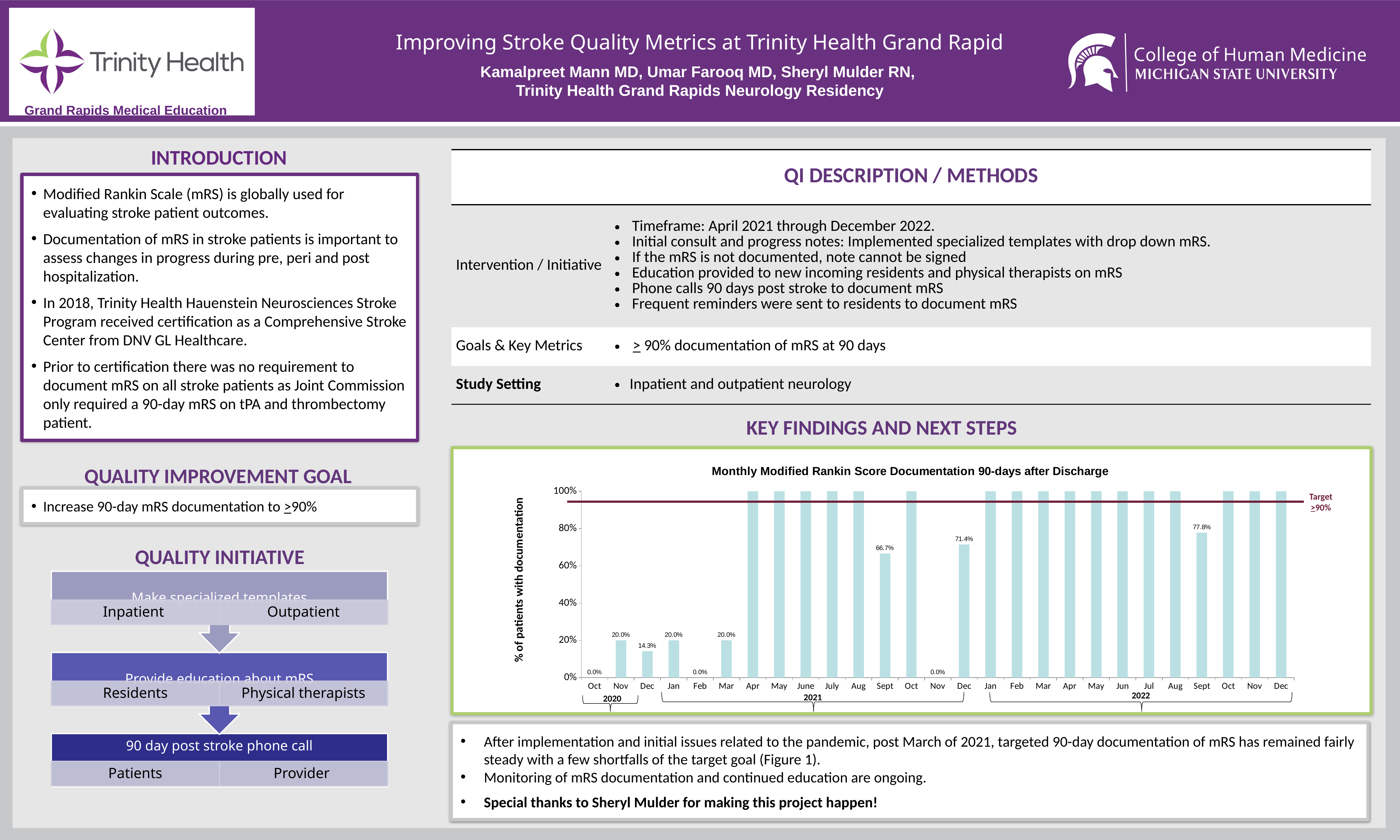
What is the title of the chart? Monthly Modified Rankin Score Documentation 90-days after Discharge What is the documentation percentage for Sept 2021? 66.7% By how many percentage points does Sept 2022 exceed Sept 2021? 11.1 percentage points What target value is marked by the horizontal line on the chart? ≥90% What is the documentation percentage for Dec 2021? 71.4% What is the documentation percentage for Nov 2020? 20.0% What kind of chart is shown under Key Findings and Next Steps? Bar chart Is the value for Apr 2021 greater or less than 80%? greater How many months are plotted on the x axis of the chart? 27 What is the documentation percentage for Sept 2022? 77.8% Which month has the higher documentation percentage, Sept 2021 or Dec 2021? Dec 2021 What is the documentation percentage for Dec 2020? 14.3%